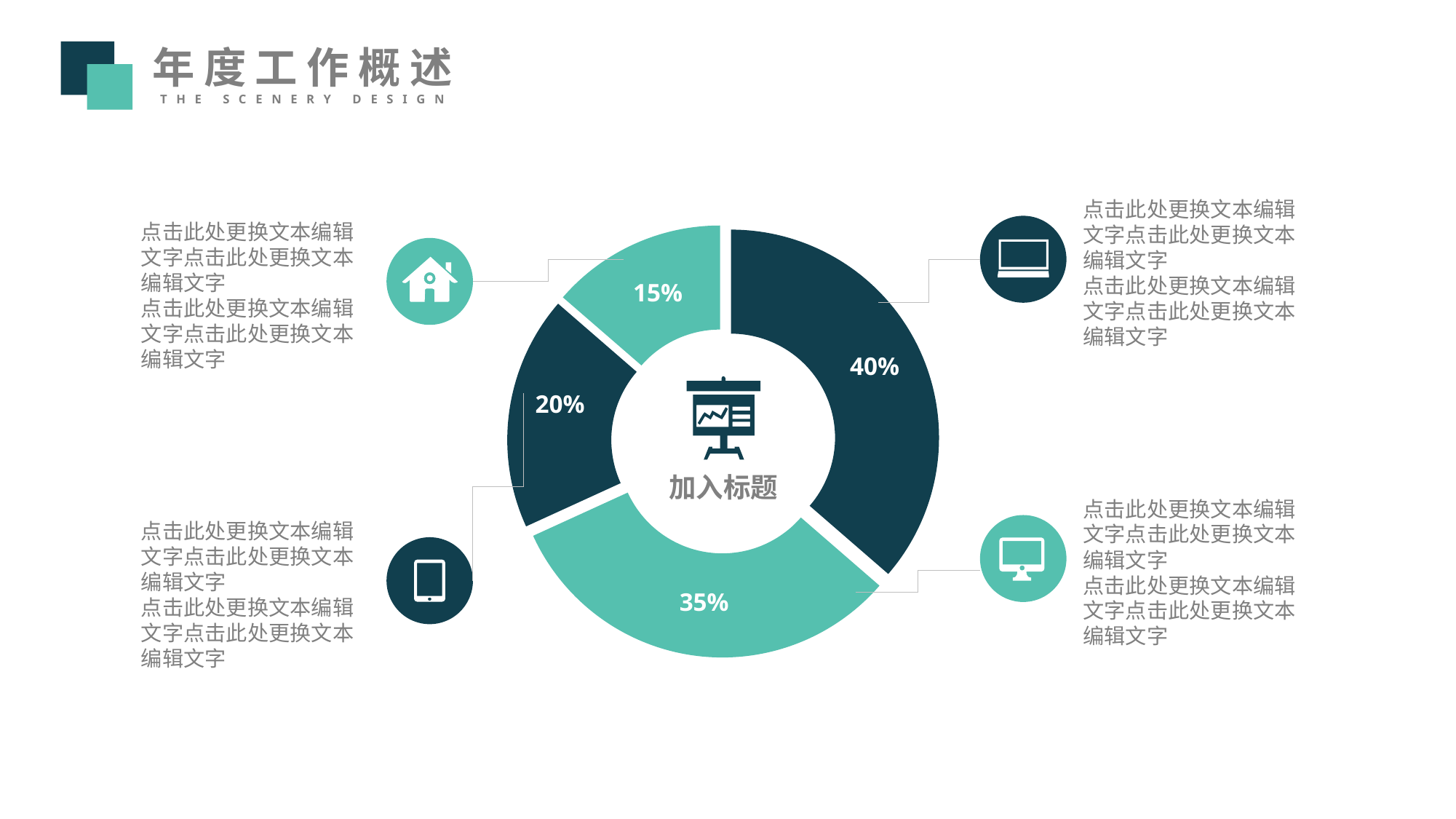
How many slices does the donut chart have? 4 What is the value of the largest slice in the donut chart? 40% Which is larger in the donut chart: the bottom slice or the left slice? The bottom slice (35%) What percentage is shown on the dark slice on the right side of the donut chart? 40% What percentage is shown on the light green slice at the top-left of the donut chart? 15% What do the four slice percentages in the donut chart add up to? 110% What percentage is shown on the light green slice at the bottom of the donut chart? 35% What percentage is shown on the dark slice on the left side of the donut chart? 20% What is the value of the smallest slice in the donut chart? 15% What kind of chart is shown in the centre of the slide? Donut (pie) chart What is the difference between the largest slice (40%) and the smallest slice (15%) in the donut chart? 25% What text is shown in the centre of the donut chart? 加入标题